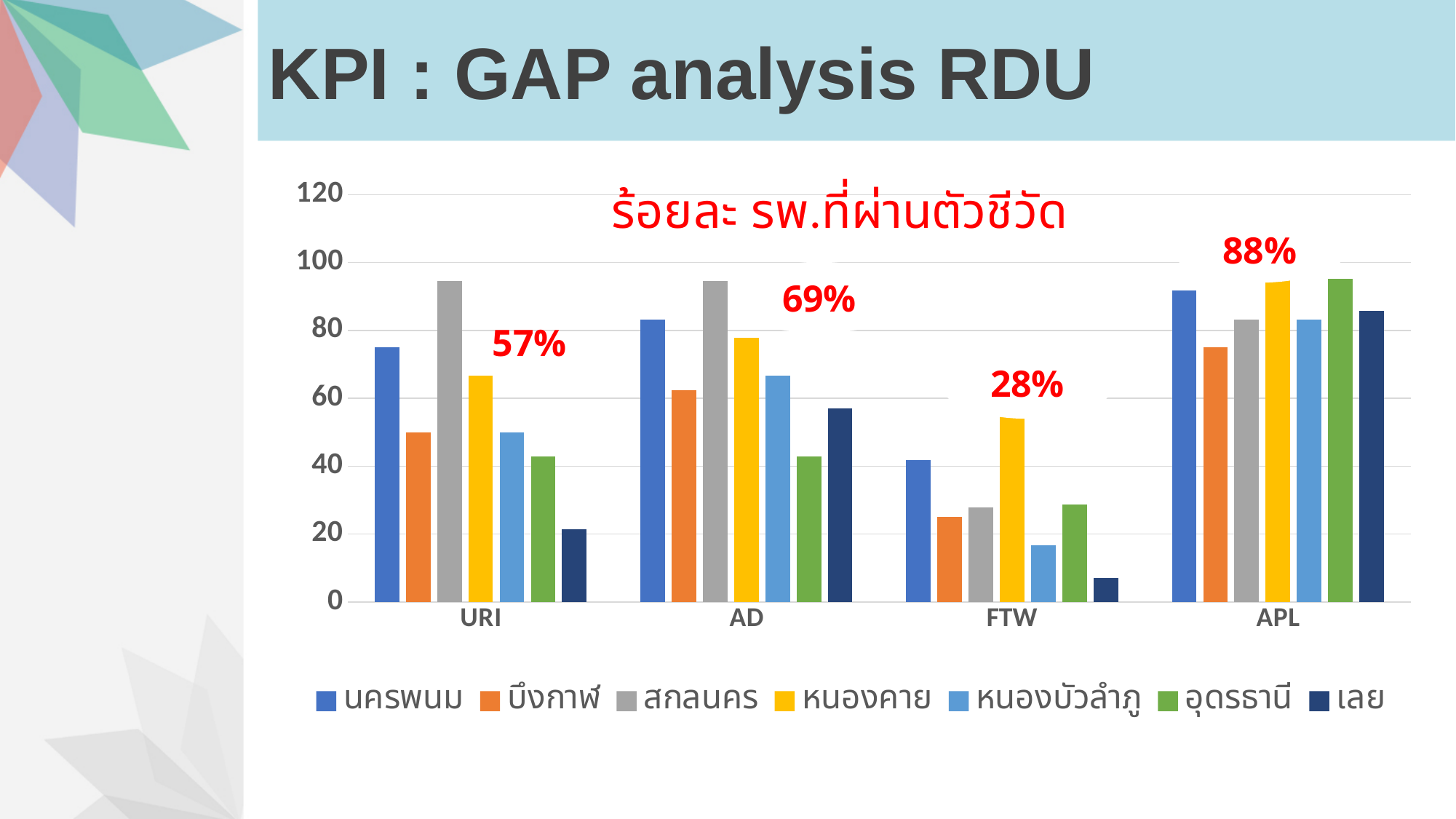
Is the value for เลย in the FTW category greater or less than 20? less Which series has the highest value in the URI category? สกลนคร How many categories are shown on the x axis of the chart? 4 What red percentage label is printed above the FTW group? 28% Which series has the lowest value in the FTW category? เลย In the URI category, which is larger: นครพนม or บึงกาฬ? นครพนม Which series has the highest value in the FTW category? หนองคาย Which series has the lowest value in the APL category? บึงกาฬ What kind of chart is shown on the slide? bar chart Is the value for สกลนคร in the URI category greater or less than 80? greater What red percentage label is printed above the APL group? 88% How many series does the chart legend list? 7